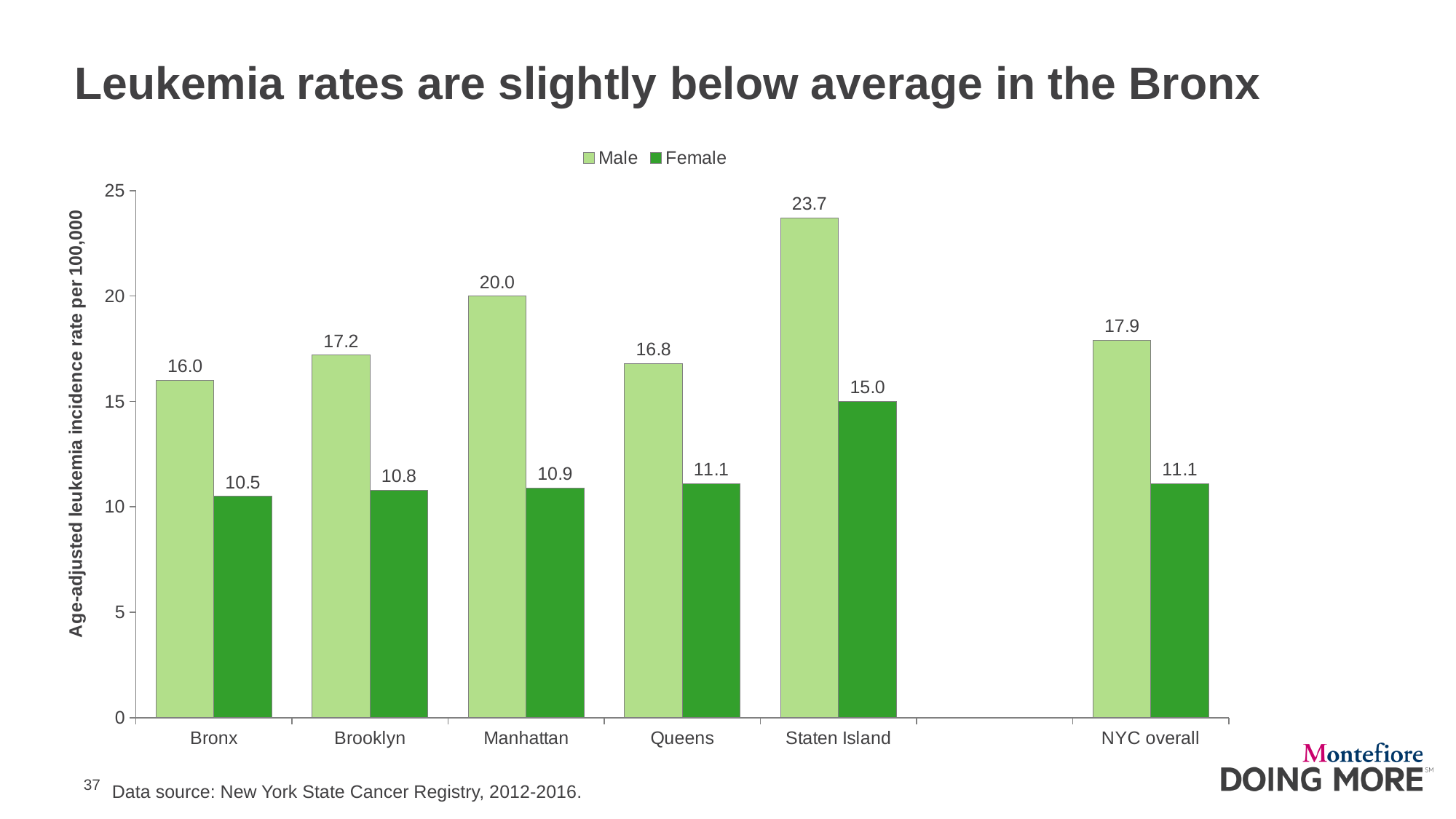
How many series does the legend list? 2 What kind of chart is shown on the slide? Bar chart How many categories are shown on the x axis? 6 What is the difference between the Male value for NYC overall and the Male value for the Bronx? 1.9 Which category has the lowest Female value? Bronx What is the Male leukemia incidence rate for the Bronx? 16.0 What is the Female value for NYC overall? 11.1 Is the Male value for Staten Island greater or less than 20? greater Which is larger, the Male value for Brooklyn or the Male value for Queens? Brooklyn What is the Female leukemia incidence rate for Staten Island? 15.0 Which category has the highest Male value? Staten Island What is the difference between the Male and Female values for Manhattan? 9.1